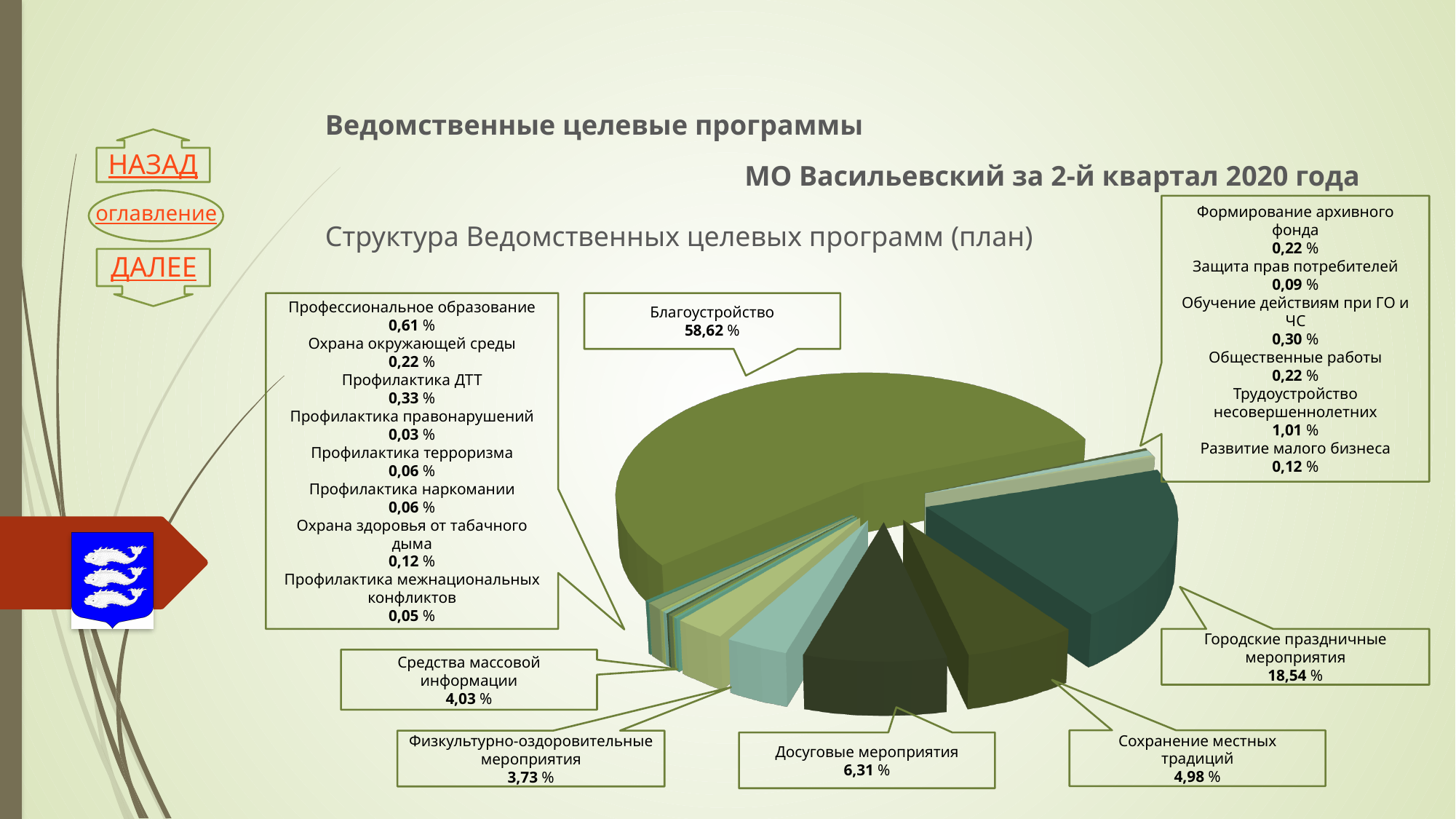
What is the difference in percentage points between Благоустройство and Городские праздничные мероприятия? 40,08 What is the value for Средства массовой информации? 4,03 % What is the value shown for Городские праздничные мероприятия? 18,54 % What type of chart is shown on the slide? Pie chart Which is larger: Досуговые мероприятия or Средства массовой информации? Досуговые мероприятия What share is shown for Трудоустройство несовершеннолетних? 1,01 % Which category has the smallest share of the pie? Профилактика правонарушений What share of the pie does Благоустройство account for? 58,62 % What percentage is shown for Досуговые мероприятия? 6,31 % Which is larger: Сохранение местных традиций or Физкультурно-оздоровительные мероприятия? Сохранение местных традиций Which category has the largest share of the pie? Благоустройство What is the title of the chart? Структура Ведомственных целевых программ (план)